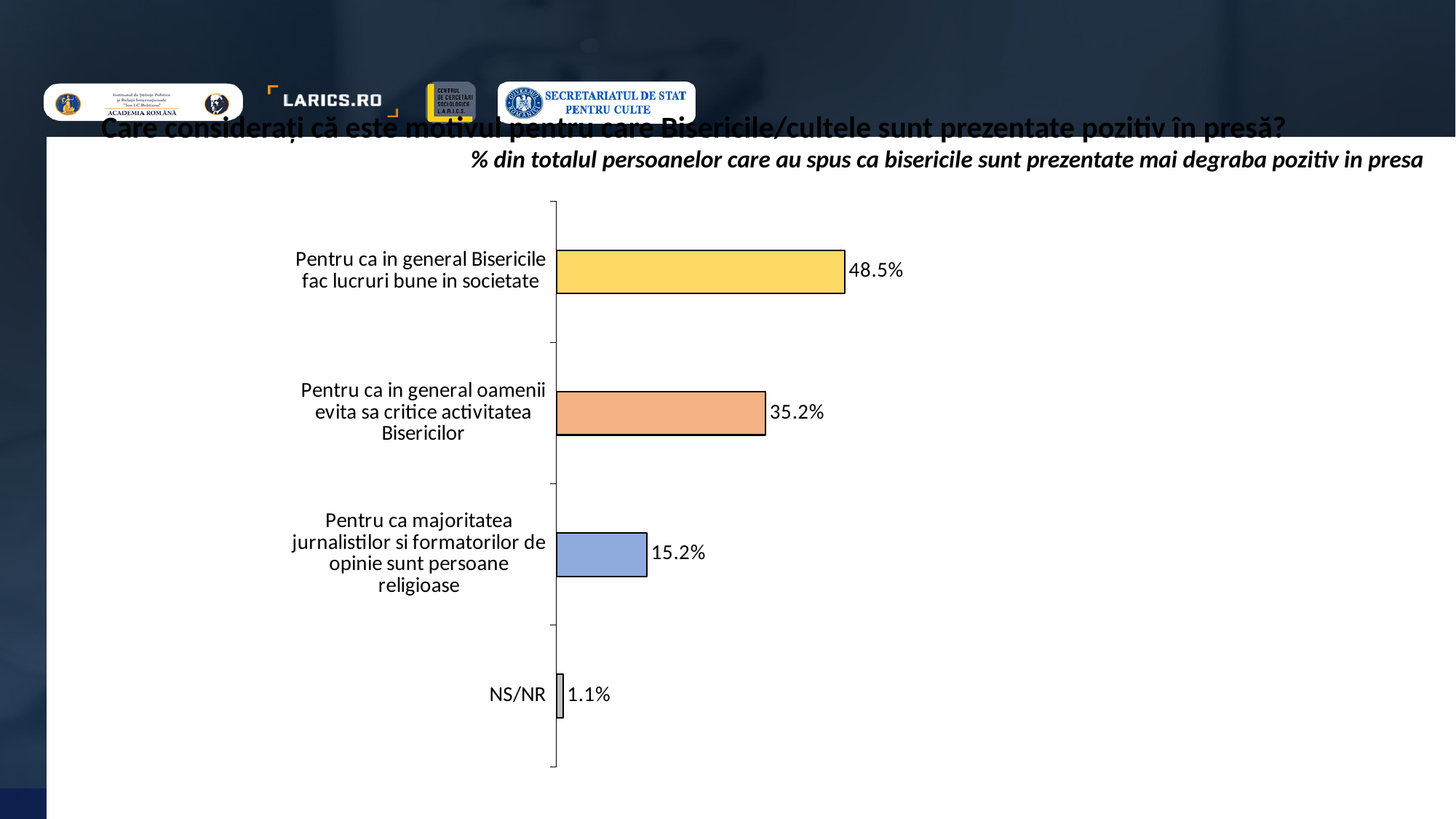
Which is larger: the value for "Pentru ca majoritatea jurnalistilor si formatorilor de opinie sunt persoane religioase" or the value for NS/NR? Pentru ca majoritatea jurnalistilor si formatorilor de opinie sunt persoane religioase How many categories are shown in the chart? 4 What kind of chart is shown on the slide? Bar chart What is the value for "Pentru ca majoritatea jurnalistilor si formatorilor de opinie sunt persoane religioase"? 15.2% What is the difference between the values for "Pentru ca in general oamenii evita sa critice activitatea Bisericilor" and "Pentru ca majoritatea jurnalistilor si formatorilor de opinie sunt persoane religioase"? 20.0% What colour is the bar for "Pentru ca in general Bisericile fac lucruri bune in societate"? Yellow What is the difference between the values for "Pentru ca in general Bisericile fac lucruri bune in societate" and "Pentru ca in general oamenii evita sa critice activitatea Bisericilor"? 13.3% What is the value for "Pentru ca in general Bisericile fac lucruri bune in societate"? 48.5% What is the value for NS/NR? 1.1% Which category has the lowest value? NS/NR What is the value for "Pentru ca in general oamenii evita sa critice activitatea Bisericilor"? 35.2% Which category has the highest value? Pentru ca in general Bisericile fac lucruri bune in societate